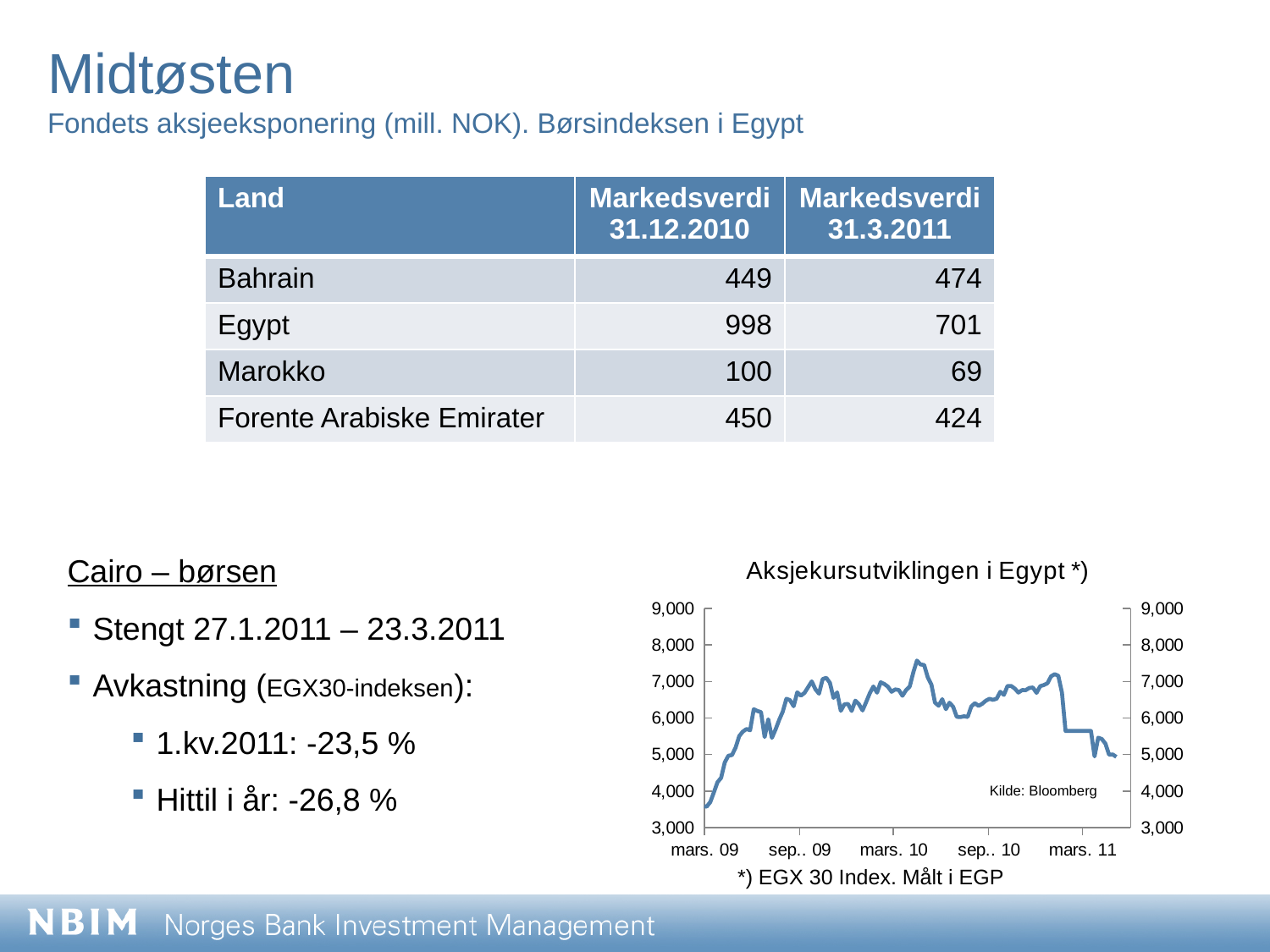
What kind of chart is "Aksjekursutviklingen i Egypt *)"? line chart What source is cited inside the chart "Aksjekursutviklingen i Egypt *)"? Kilde: Bloomberg In the chart "Aksjekursutviklingen i Egypt *)", is the value at mars. 10 greater or less than 6,000? greater What is the highest value shown on the y axis of the chart "Aksjekursutviklingen i Egypt *)"? 9,000 How many date labels are shown on the x axis of the chart "Aksjekursutviklingen i Egypt *)"? 5 In the chart "Aksjekursutviklingen i Egypt *)", which is larger: the value at mars. 10 or the value at mars. 11? mars. 10 In the chart "Aksjekursutviklingen i Egypt *)", does the line rise or fall between mars. 09 and mars. 10? rise In the chart "Aksjekursutviklingen i Egypt *)", is the highest point of the line greater or less than 7,000? greater In the chart "Aksjekursutviklingen i Egypt *)", is the value at mars. 09 greater or less than 4,000? less In the chart "Aksjekursutviklingen i Egypt *)", does the line rise or fall between mars. 10 and mars. 11? fall